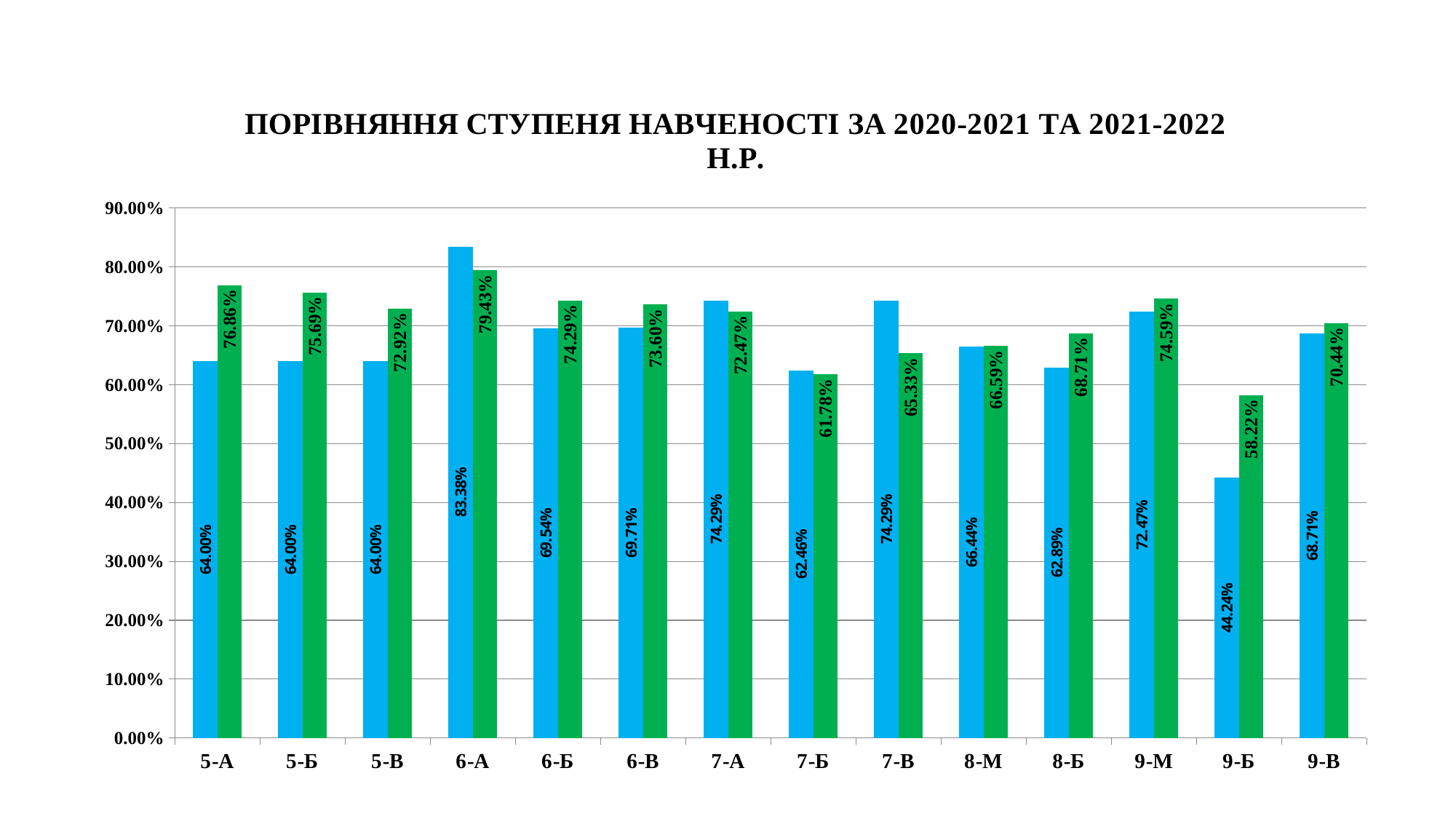
Which category has the highest green bar? 6-А How many categories are shown on the x axis? 14 What is the value of the green bar for 5-А? 76.86% Is the blue bar for 9-Б greater or less than 50.00%? less What is the difference between the green and blue bars for 9-Б? 13.98% Which category has the lowest blue bar? 9-Б What is the value of the green bar for 9-Б? 58.22% What is the value of the blue bar for 6-А? 83.38% What is the value of the blue bar for 7-Б? 62.46% What is the difference between the blue and green bars for 6-А? 3.95% For 7-В, which bar is larger, the blue or the green? blue What kind of chart is shown on the slide? bar chart